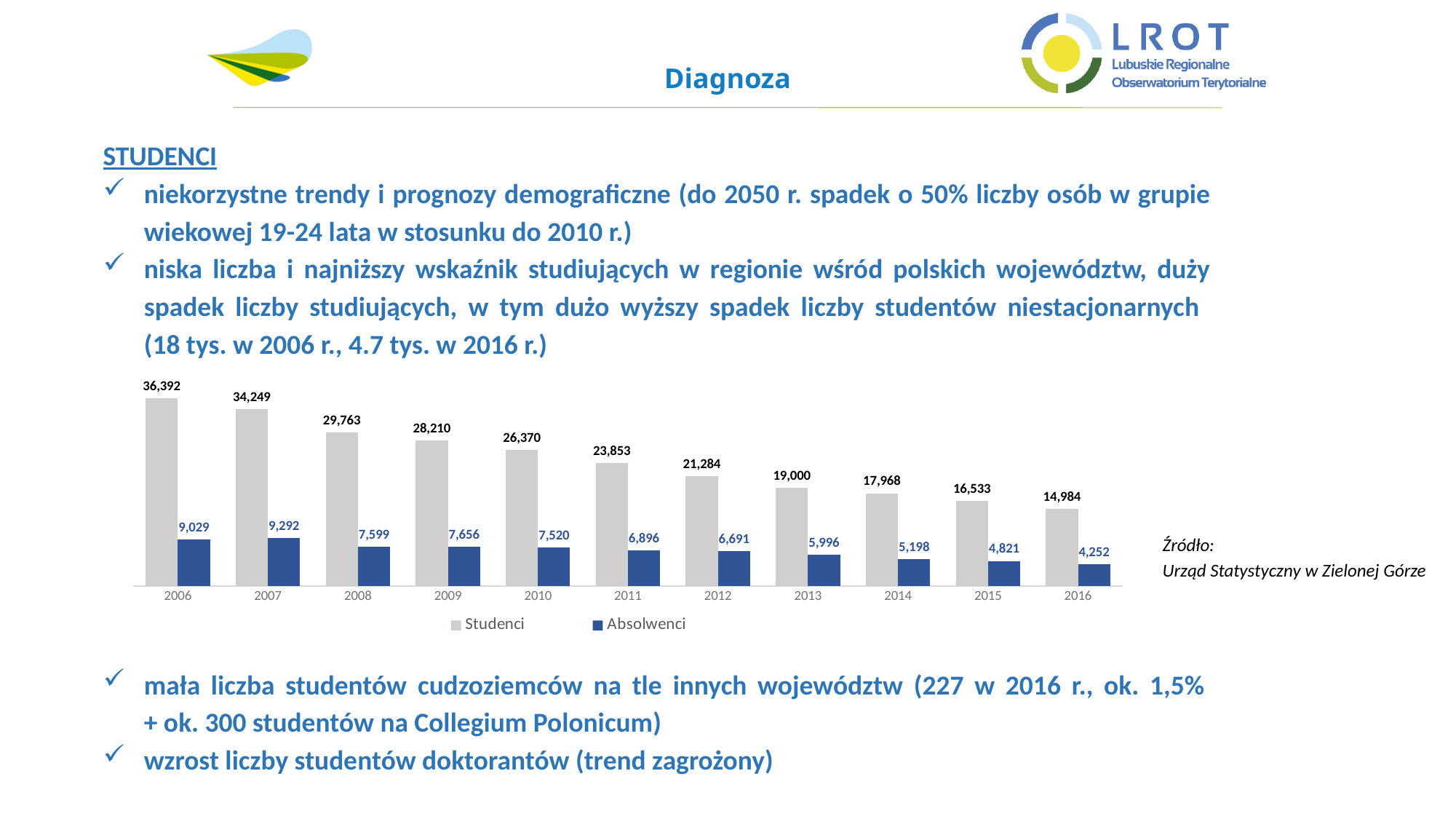
Which year has the lowest value for Studenci? 2016 What colour are the Absolwenci bars? blue Which is larger: Absolwenci in 2008 or Absolwenci in 2009? 2009 What kind of chart is shown on the slide? bar chart What is the value for Absolwenci in 2010? 7,520 Do the Studenci values rise or fall from 2006 to 2016? fall What is the value for Studenci in 2006? 36,392 How many series does the legend list? 2 How many years are shown on the x axis? 11 What is the value for Absolwenci in 2016? 4,252 Which year has the highest value for Absolwenci? 2007 What is the difference between the Studenci values for 2006 and 2016? 21,408